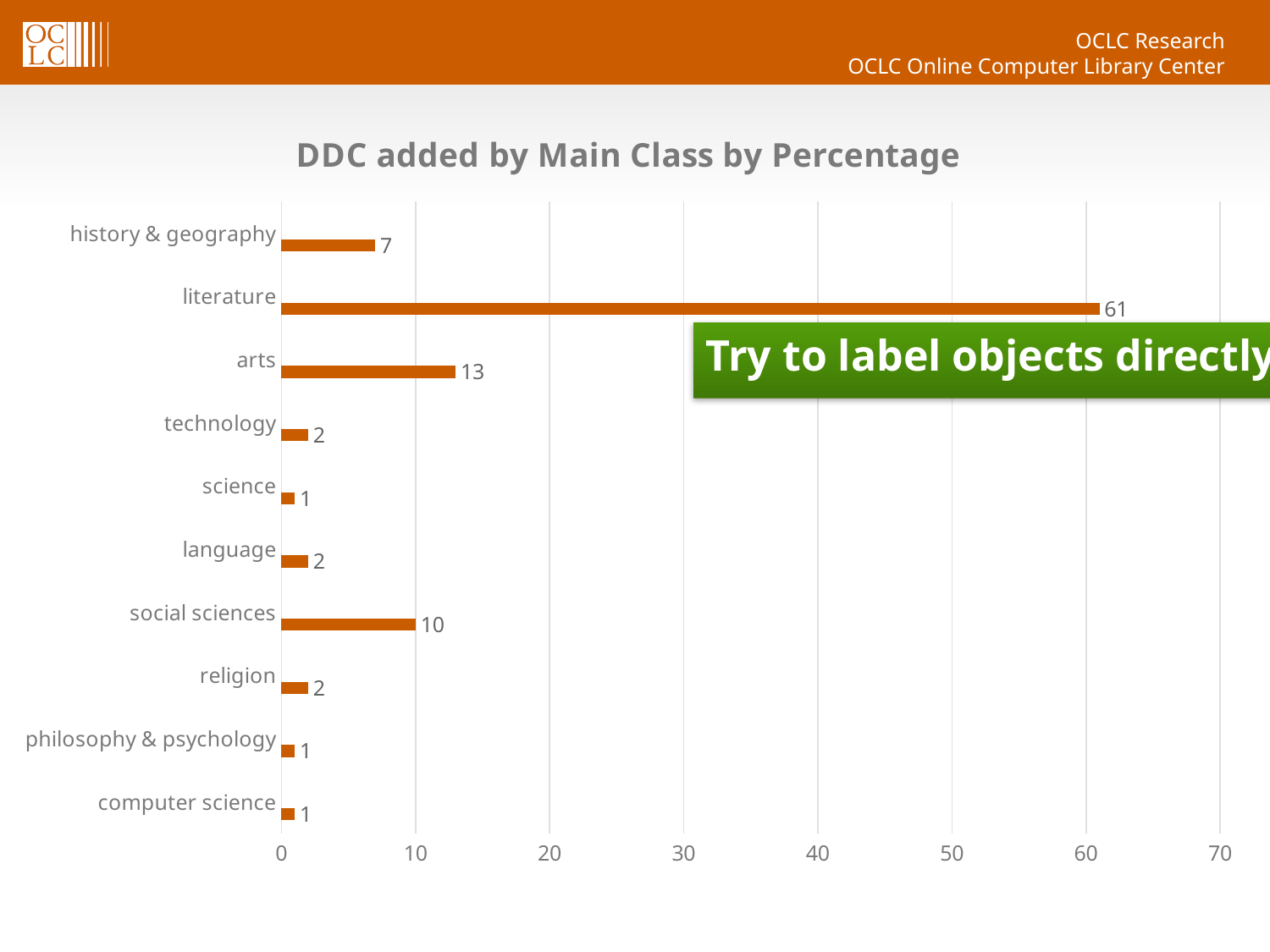
Is the value for literature greater or less than 50? greater What is the value for literature? 61 What is the difference between the values for arts and social sciences? 3 What is the value for arts? 13 Which category has the highest value? literature What is the title of the chart? DDC added by Main Class by Percentage How many categories are shown in the chart? 10 What is the difference between the values for literature and arts? 48 What is the value for social sciences? 10 What is the value for history & geography? 7 Which is larger, the value for history & geography or the value for social sciences? social sciences What kind of chart is shown on the slide? bar chart